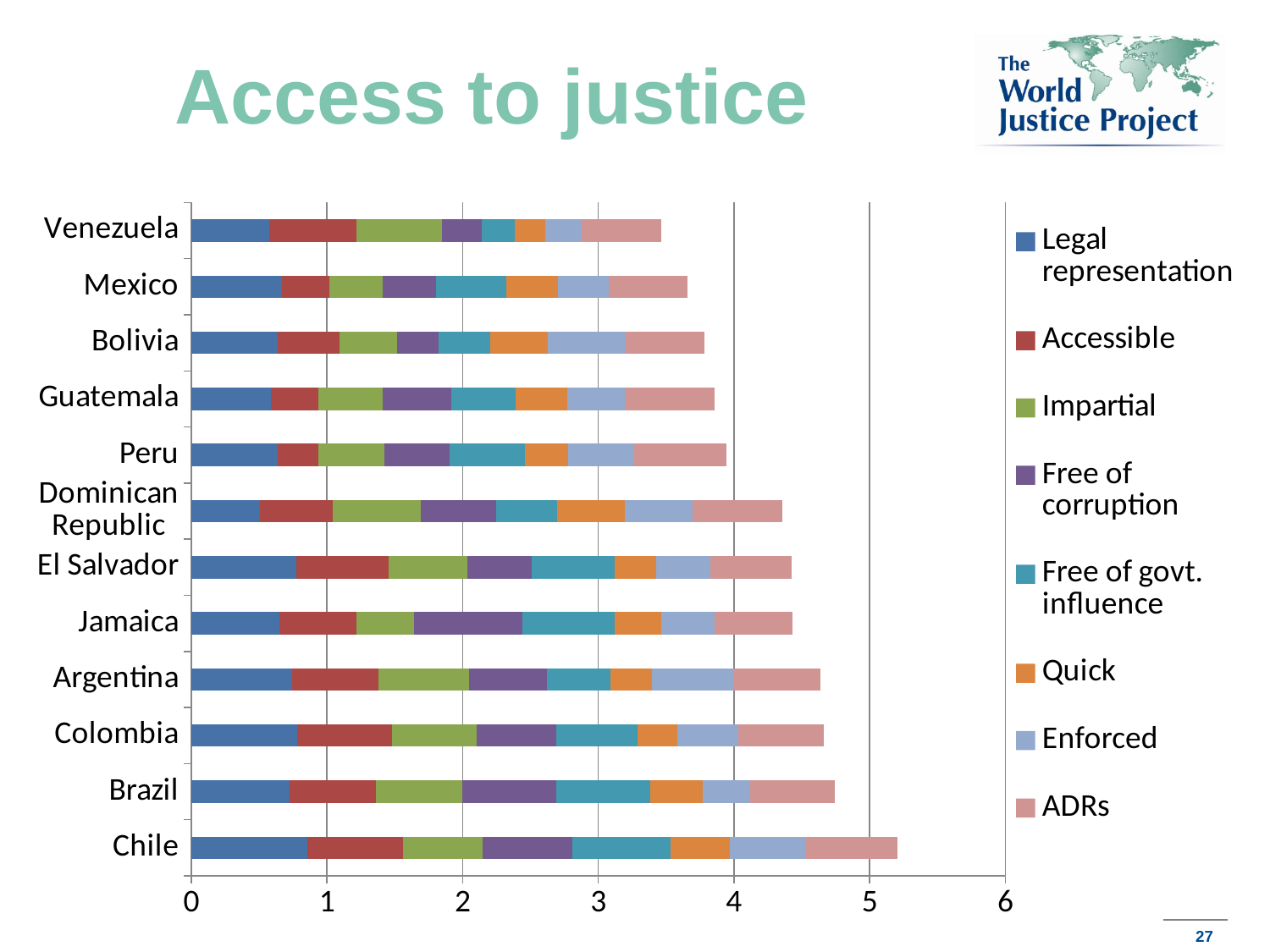
Is the total bar length for Bolivia greater or less than 4? less Which series is listed first in the legend? Legal representation How many series does the legend list? 8 Is the total bar length for Dominican Republic greater or less than 4? greater Which country has the longest total bar? Chile Which country has a longer total bar, Argentina or Guatemala? Argentina How many countries are listed on the chart? 12 What is the title of the chart? Access to justice What kind of chart is shown on the slide? Stacked bar chart Is the total bar length for Chile greater or less than 5? greater Which country has the shortest total bar? Venezuela